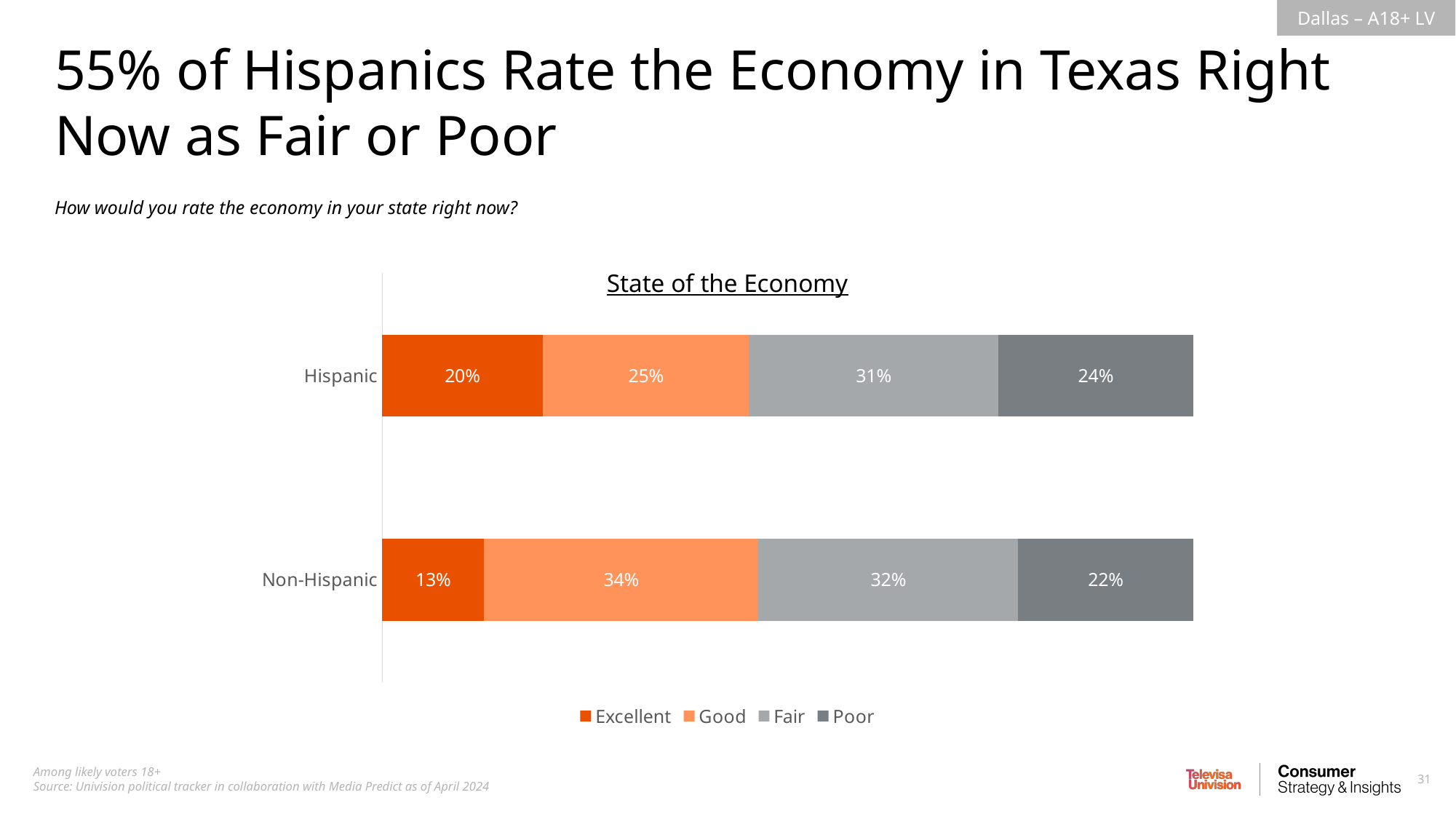
How many groups are shown on the chart? 2 What percentage of Non-Hispanic respondents rate the economy as Fair? 32% Which rating has the smallest share among Non-Hispanic respondents? Excellent Which group has a larger Excellent share, Hispanic or Non-Hispanic? Hispanic What is the difference between the Good share for Non-Hispanic and Hispanic respondents? 9 percentage points What type of chart is shown on the slide? Stacked bar chart How many series does the legend list? 4 What percentage of Hispanic respondents rate the economy as Excellent? 20% What percentage of Non-Hispanic respondents rate the economy as Good? 34% What is the combined Fair and Poor share for Hispanic respondents? 55% What percentage of Hispanic respondents rate the economy as Poor? 24% Which rating has the largest share among Hispanic respondents? Fair